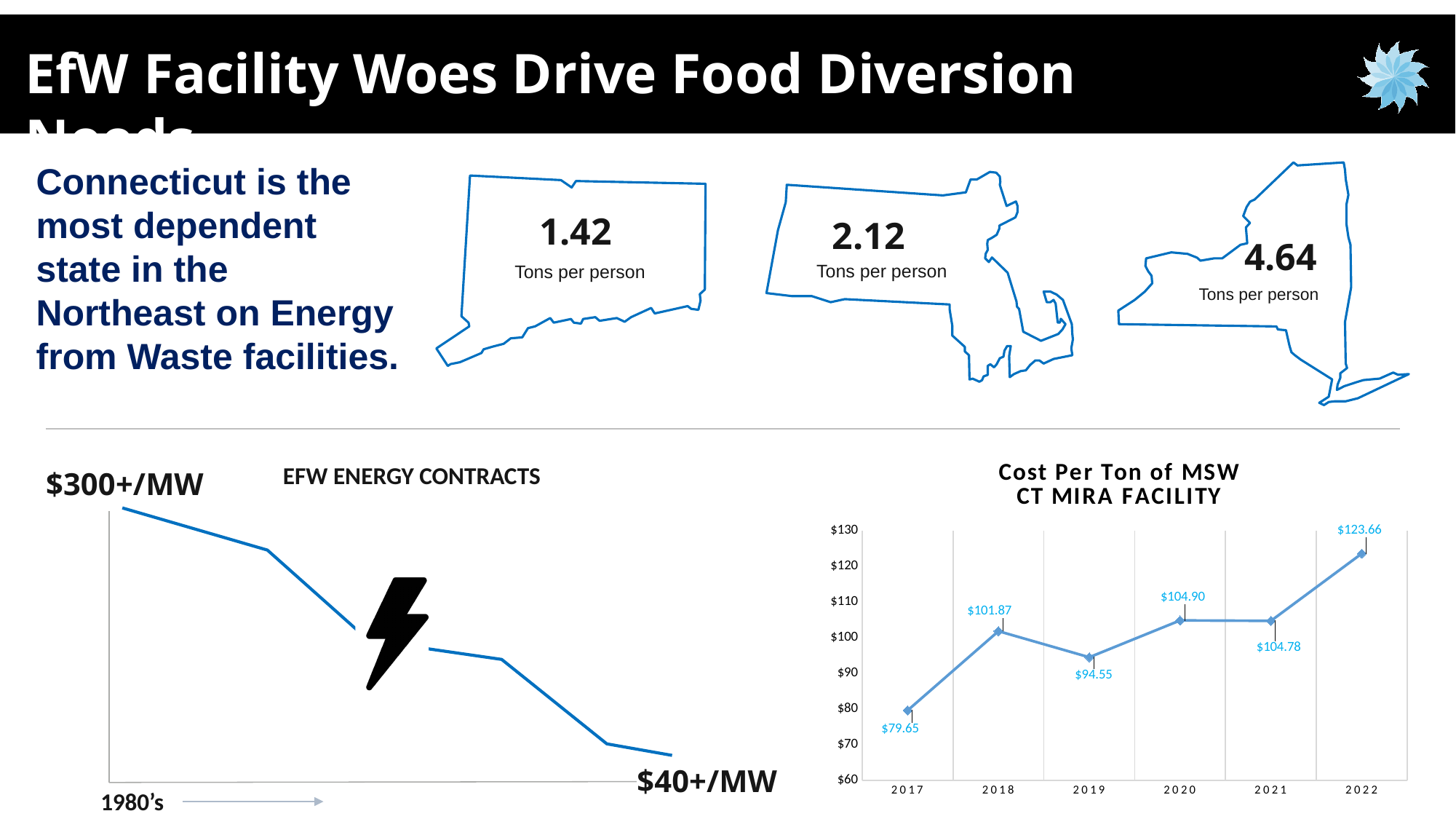
What kind of chart is the Cost Per Ton of MSW CT MIRA FACILITY chart? line chart In the Cost Per Ton of MSW CT MIRA FACILITY chart, what was the cost per ton in 2022? $123.66 In the EFW ENERGY CONTRACTS chart, what value is labelled at the end of the line on the right? $40+/MW In the Cost Per Ton of MSW CT MIRA FACILITY chart, which year has the highest cost per ton? 2022 In the Cost Per Ton of MSW CT MIRA FACILITY chart, which year has the larger cost per ton, 2018 or 2019? 2018 In the Cost Per Ton of MSW CT MIRA FACILITY chart, which year has the lowest cost per ton? 2017 In the Cost Per Ton of MSW CT MIRA FACILITY chart, how much higher is the 2022 cost per ton than the 2017 cost per ton? $44.01 In the EFW ENERGY CONTRACTS chart, what decade is labelled at the start of the x axis? 1980's In the Cost Per Ton of MSW CT MIRA FACILITY chart, what was the cost per ton in 2017? $79.65 In the EFW ENERGY CONTRACTS chart, do the values rise or fall from left to right? fall In the Cost Per Ton of MSW CT MIRA FACILITY chart, how many years are plotted? 6 In the Cost Per Ton of MSW CT MIRA FACILITY chart, what was the cost per ton in 2019? $94.55